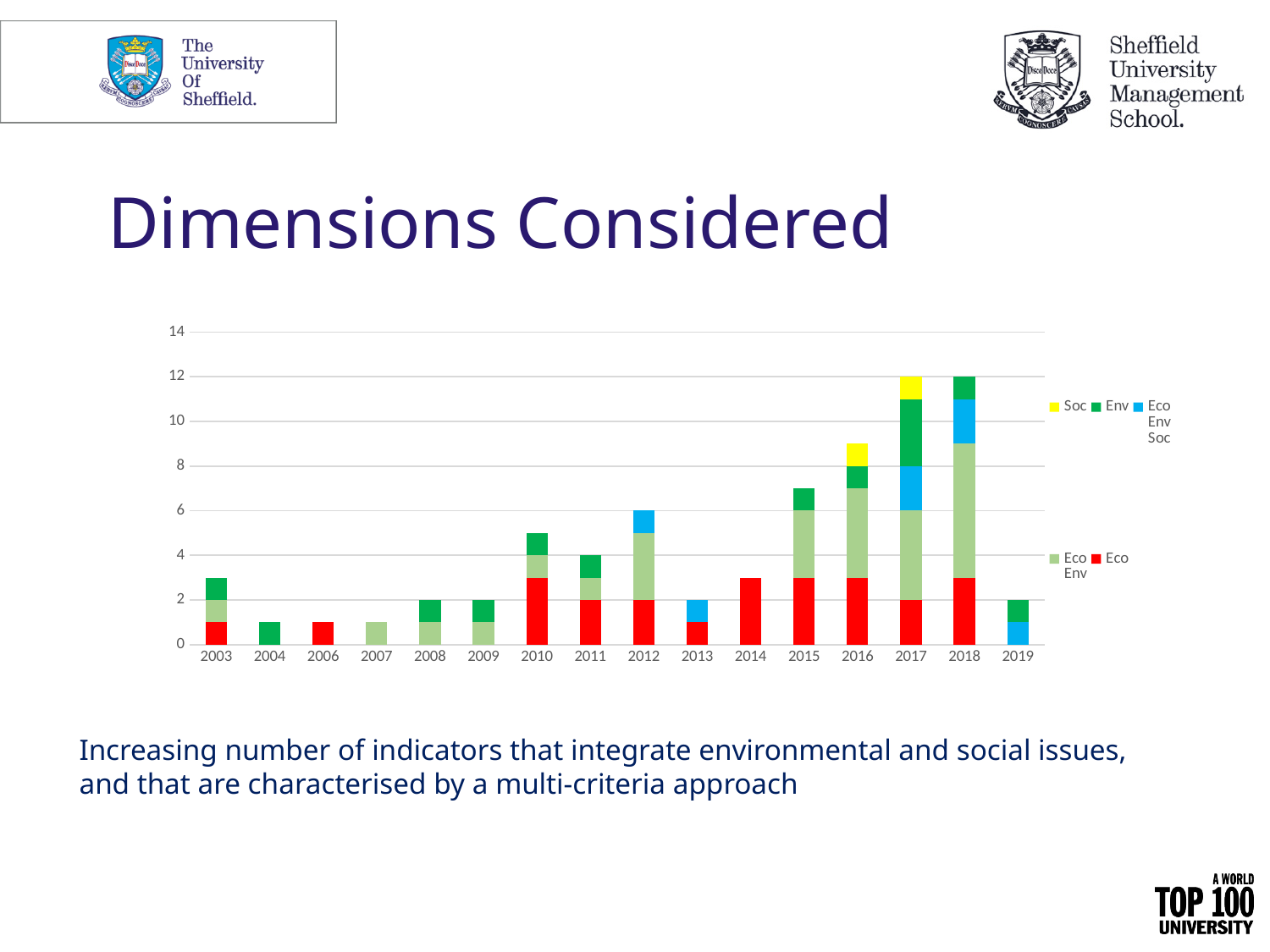
Do the bar totals generally rise or fall from 2003 to 2018? Rise What is the total height of the stacked bar for 2018? 12 What is the total height of the stacked bar for 2012? 6 What is the total height of the stacked bar for 2011? 4 Which year has a taller stacked bar, 2015 or 2016? 2016 How many series does the chart's legend list? 5 Which series in the legend is shown in yellow? Soc Is the total for 2014 greater or less than 4? less Which year has a taller stacked bar, 2010 or 2014? 2010 Is the total for 2016 greater or less than 8? greater What kind of chart is shown on the slide? Stacked bar chart How many years are shown along the x axis of the chart? 16